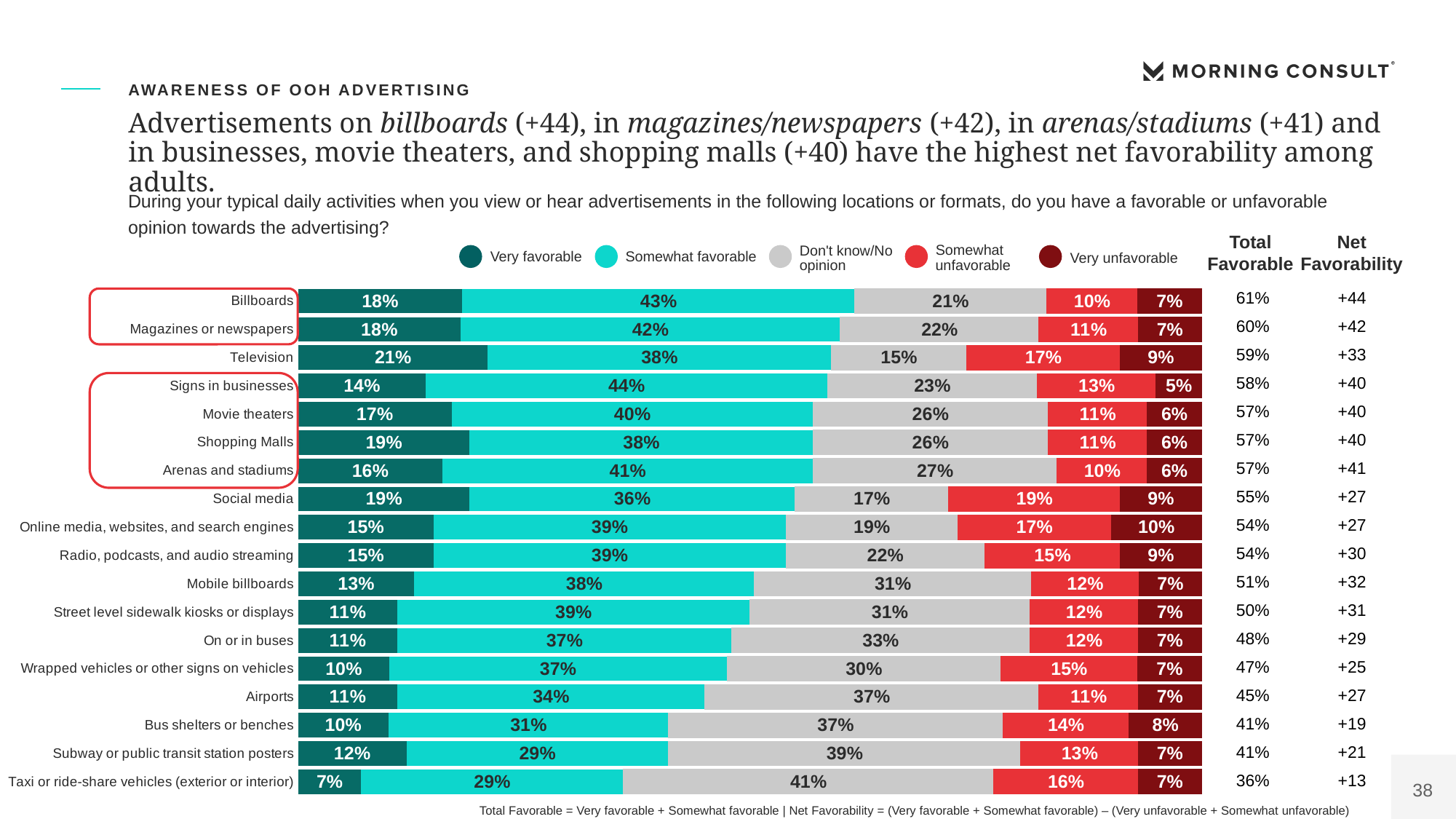
What is the 'Very favorable' value for Television? 21% How many locations or formats are plotted in the chart? 18 Which is larger: the 'Somewhat favorable' value for Billboards or the 'Somewhat favorable' value for Airports? Billboards How many series does the legend list? 5 Which location or format has the highest 'Somewhat favorable' value? Signs in businesses What is the 'Don't know/No opinion' value for Taxi or ride-share vehicles (exterior or interior)? 41% What is the difference between the 'Very favorable' value for Television and the 'Very favorable' value for Taxi or ride-share vehicles (exterior or interior)? 14 percentage points What kind of chart is shown on the slide? Stacked bar chart Which location or format has the highest 'Very favorable' value? Television Which location or format has the lowest 'Very favorable' value? Taxi or ride-share vehicles (exterior or interior) What is the 'Somewhat unfavorable' value for Social media? 19% What colour represents 'Very unfavorable' in the chart? Dark red